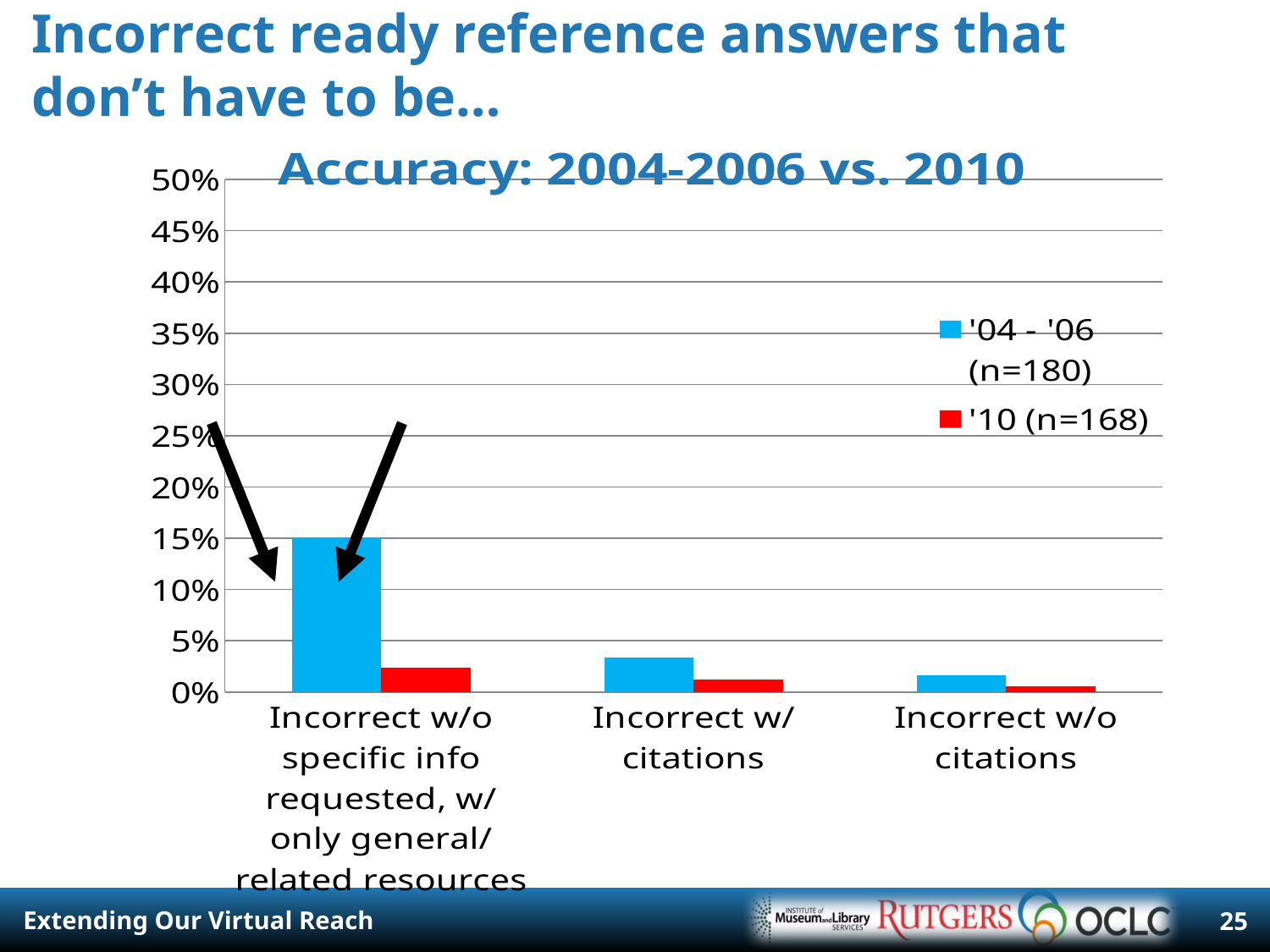
What kind of chart is shown on the slide? bar chart Is the '10 (n=168) value for 'Incorrect w/o specific info requested, w/ only general/related resources' greater or less than 5%? less Which category has the lowest value for the '10 (n=168) series? Incorrect w/o citations Do the '04 - '06 (n=180) values rise or fall moving left to right across the categories? fall How many categories are shown on the x axis? 3 Which category has the highest value for the '04 - '06 (n=180) series? Incorrect w/o specific info requested, w/ only general/related resources What is the title of the chart? Accuracy: 2004-2006 vs. 2010 What colour represents the '10 (n=168) series? red Is the '04 - '06 (n=180) value for 'Incorrect w/o specific info requested, w/ only general/related resources' greater or less than 10%? greater How many series does the legend list? 2 For the category 'Incorrect w/o specific info requested, w/ only general/related resources', which series has the larger value? '04 - '06 (n=180) Is the '04 - '06 (n=180) value for 'Incorrect w/ citations' greater or less than 5%? less